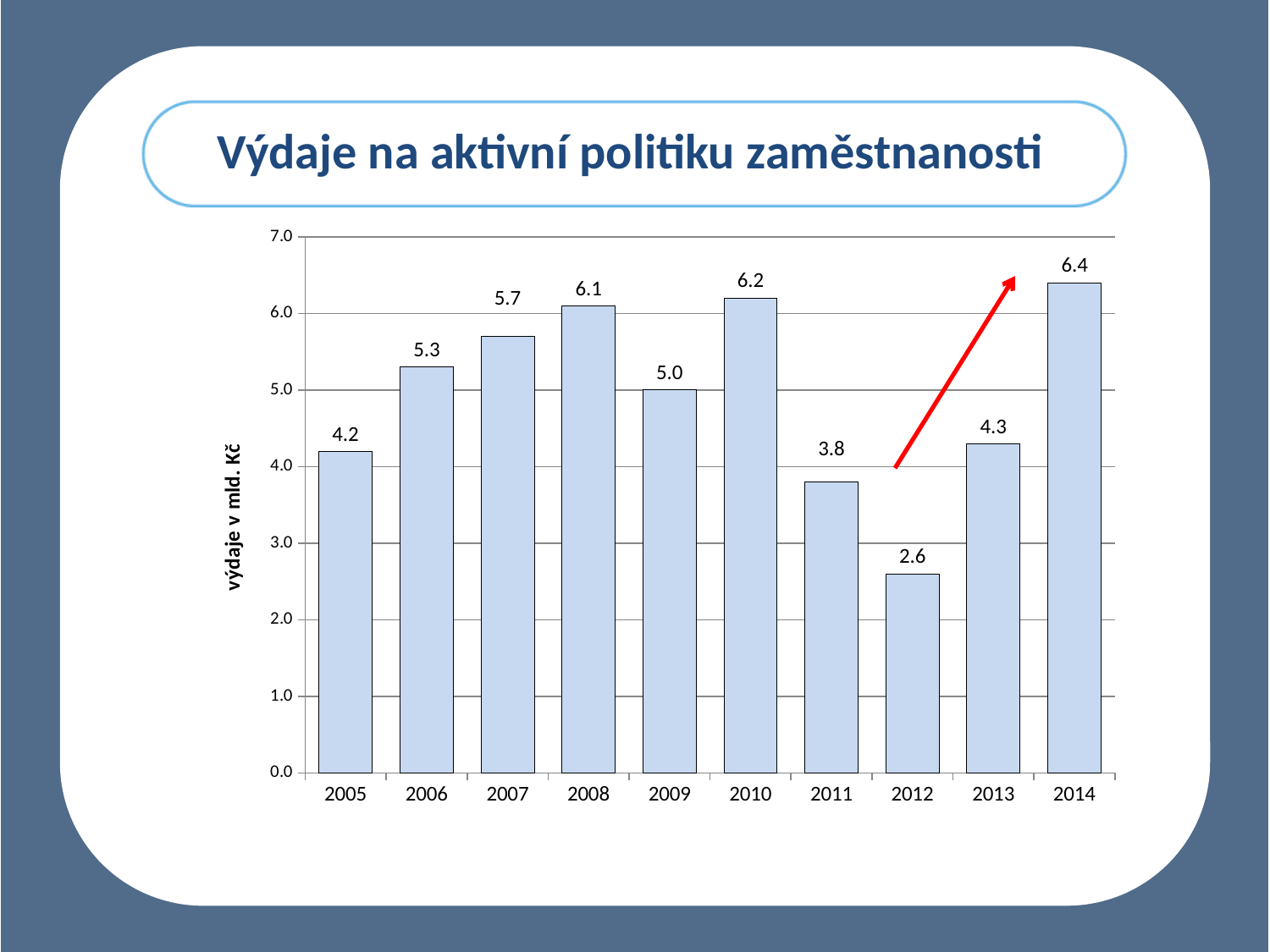
How many years are shown on the x axis? 10 What is the difference between the values for 2014 and 2012? 3.8 What kind of chart is shown on the slide? bar chart Which is larger, the value for 2007 or the value for 2009? 2007 Which year has the lowest value? 2012 Which year has the highest value? 2014 Is the value for 2013 greater or less than 4.0? greater What is the difference between the values for 2010 and 2011? 2.4 What is the label of the vertical axis? výdaje v mld. Kč What is the value for 2008? 6.1 What is the value for 2012? 2.6 What is the value for 2005? 4.2